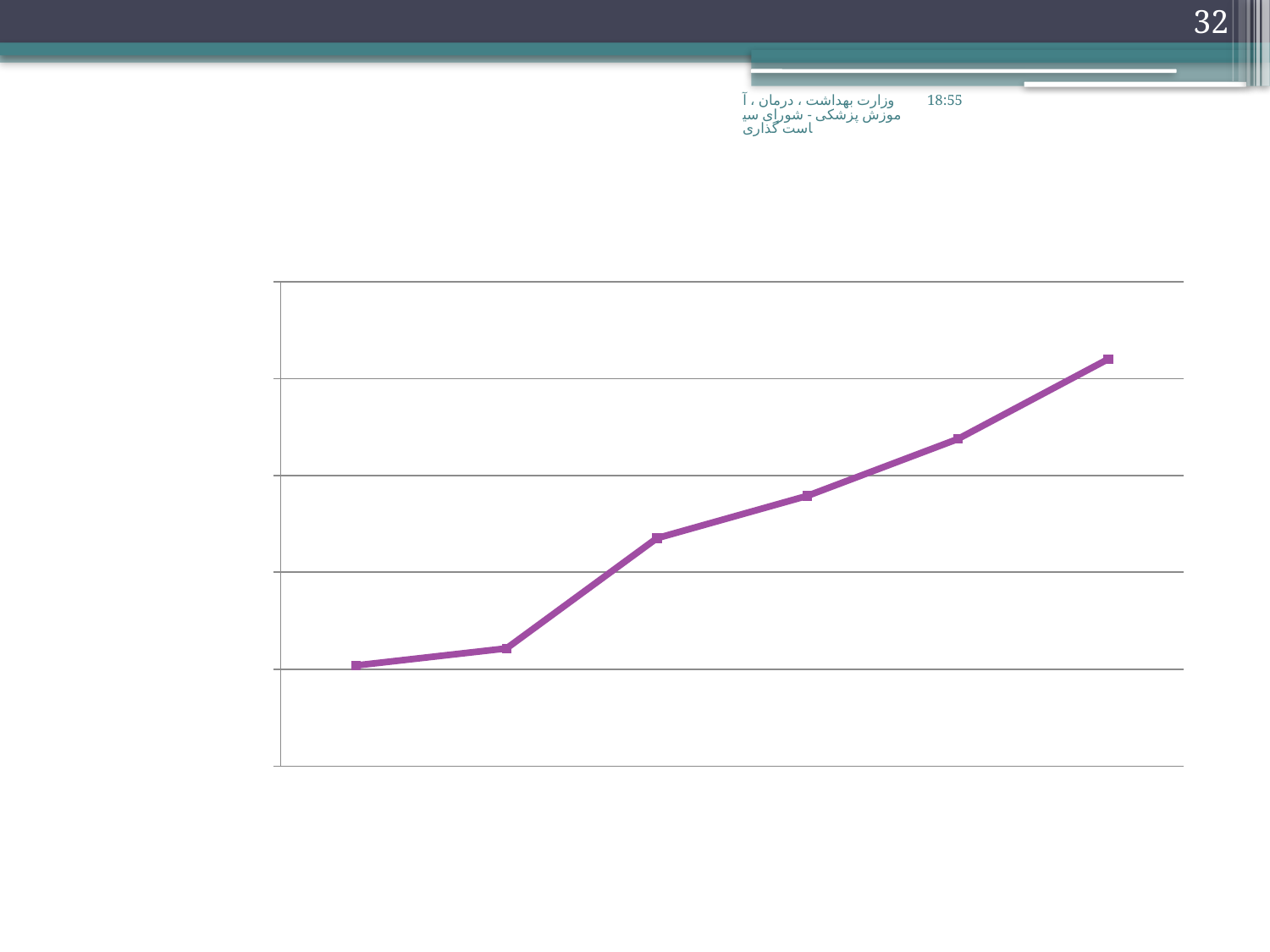
How many data points are plotted on the line? 6 Do the values rise or fall from left to right along the x axis? rise Which point on the line is the highest? the rightmost (sixth) point Which point on the line is the lowest? the leftmost (first) point What colour is the plotted line? purple What kind of chart is shown on the slide? line chart Is the leftmost point or the rightmost point higher? the rightmost point How many lines are plotted on the chart? 1